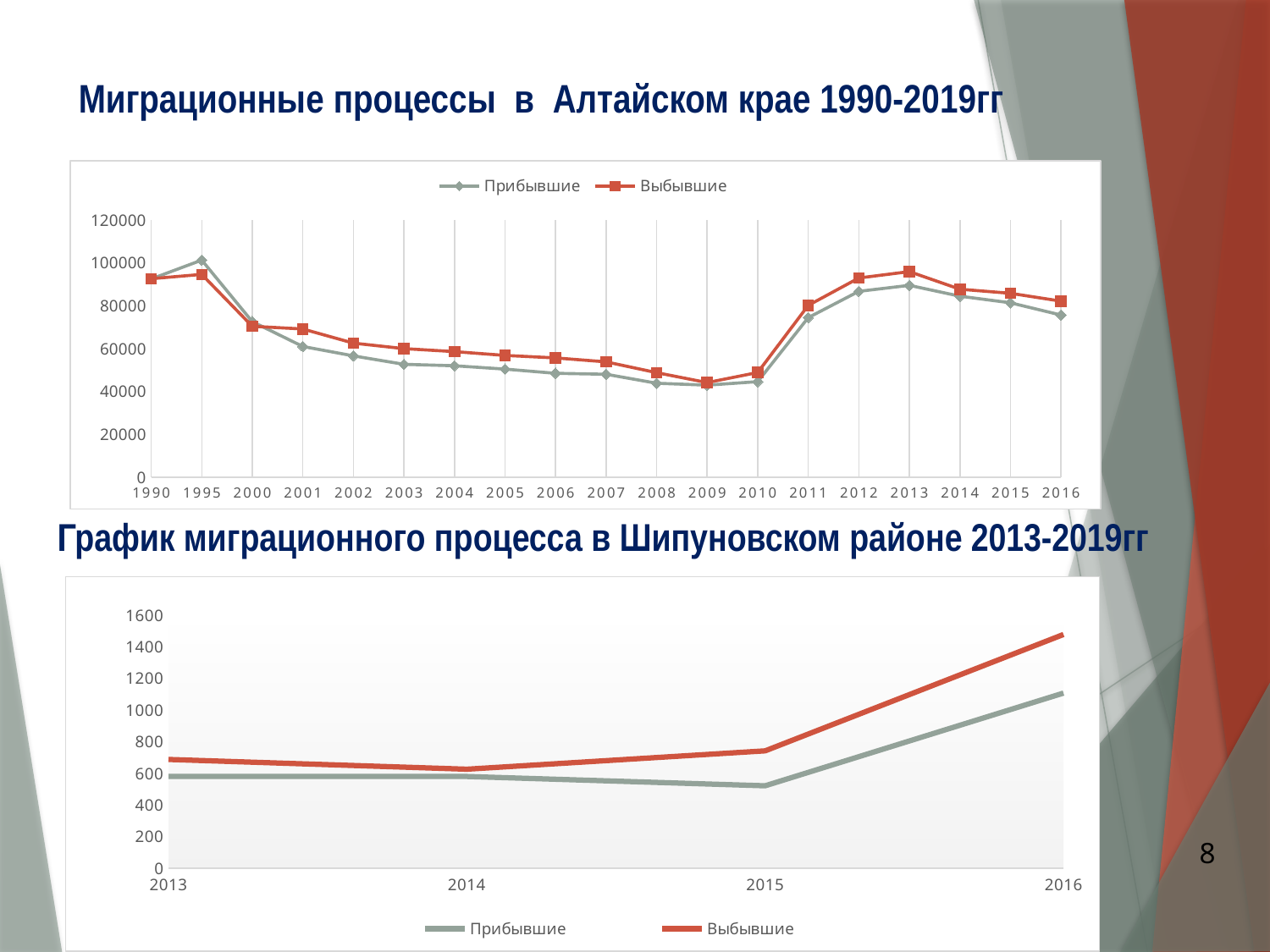
In the bottom chart, is the value for Выбывшие in 2016 greater or less than 1400? greater In the top chart, in which year is the Прибывшие series at its highest? 1995 In the top chart, in which year is the Выбывшие series at its lowest? 2009 In the top chart, is the value for Выбывшие in 2009 greater or less than 60000? less In the top chart, is the value for Прибывшие in 1995 greater or less than 100000? greater In the bottom chart, does the Выбывшие series rise or fall from 2014 to 2016? rise In the top chart, which series has the larger value in 2013, Прибывшие or Выбывшие? Выбывшие How many series does the legend of the top chart list? 2 How many data points does each series have in the bottom chart titled 'График миграционного процесса в Шипуновском районе 2013-2019гг'? 4 What kind of chart is the top chart titled 'Миграционные процессы в Алтайском крае 1990-2019гг'? line chart In the bottom chart, in which year is the Прибывшие series at its lowest? 2015 How many years are shown on the x axis of the top chart? 19